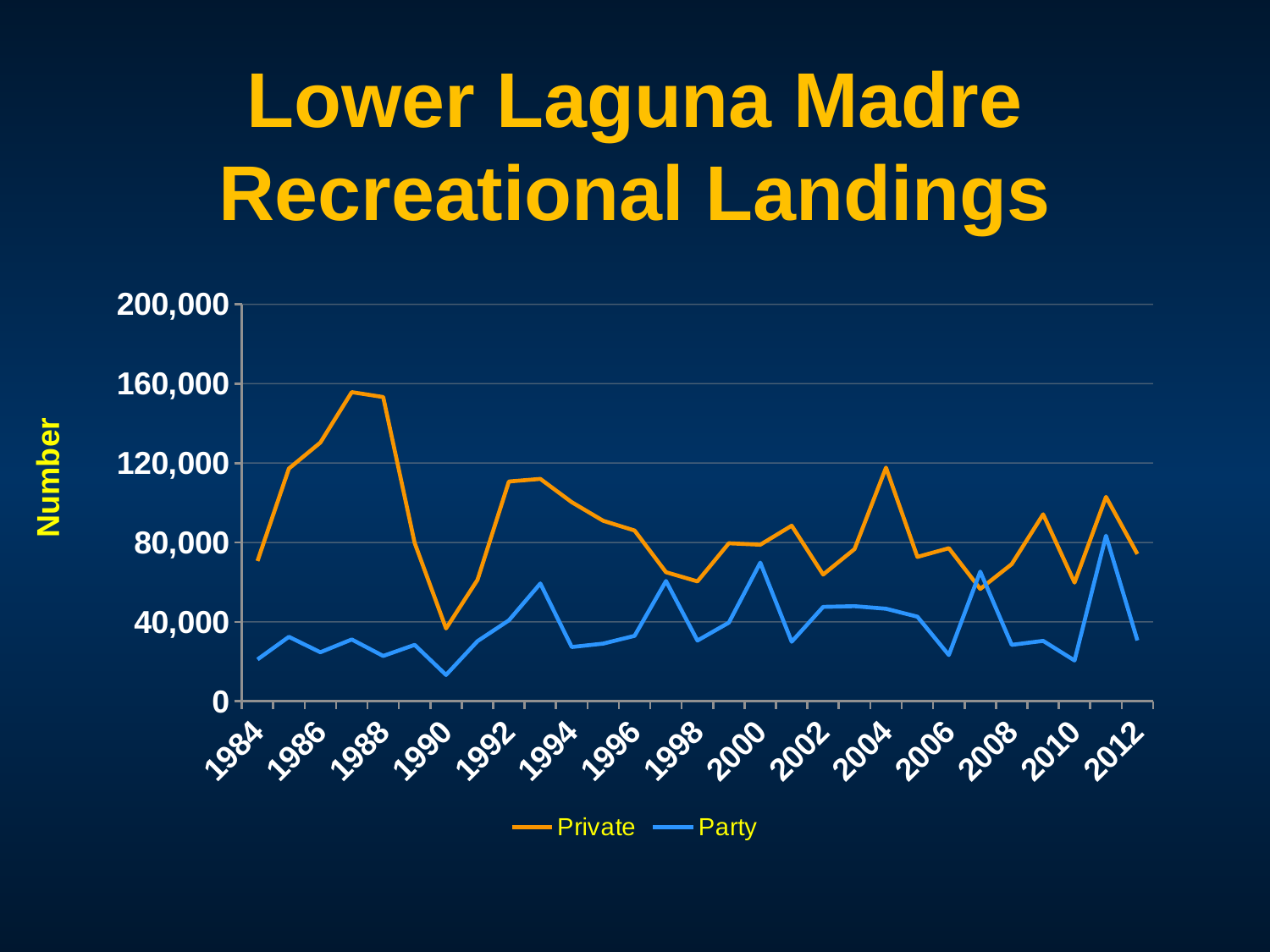
Is the Private value for 1987 greater or less than 120,000? greater Is the Party value for 1990 greater or less than 40,000? less Does the Private series rise or fall from 1987 to 1990? Fall Is the Private value for 2004 greater or less than 80,000? greater In which year does the Private series reach its highest value? 1987 What kind of chart is shown on the slide? Line chart In which year does the Party series reach its lowest value? 1990 In 1987, which series has the larger value, Private or Party? Private What is the label on the y axis? Number How many series does the legend list? 2 What are the two series named in the legend? Private and Party In which year does the Party series reach its highest value? 2011